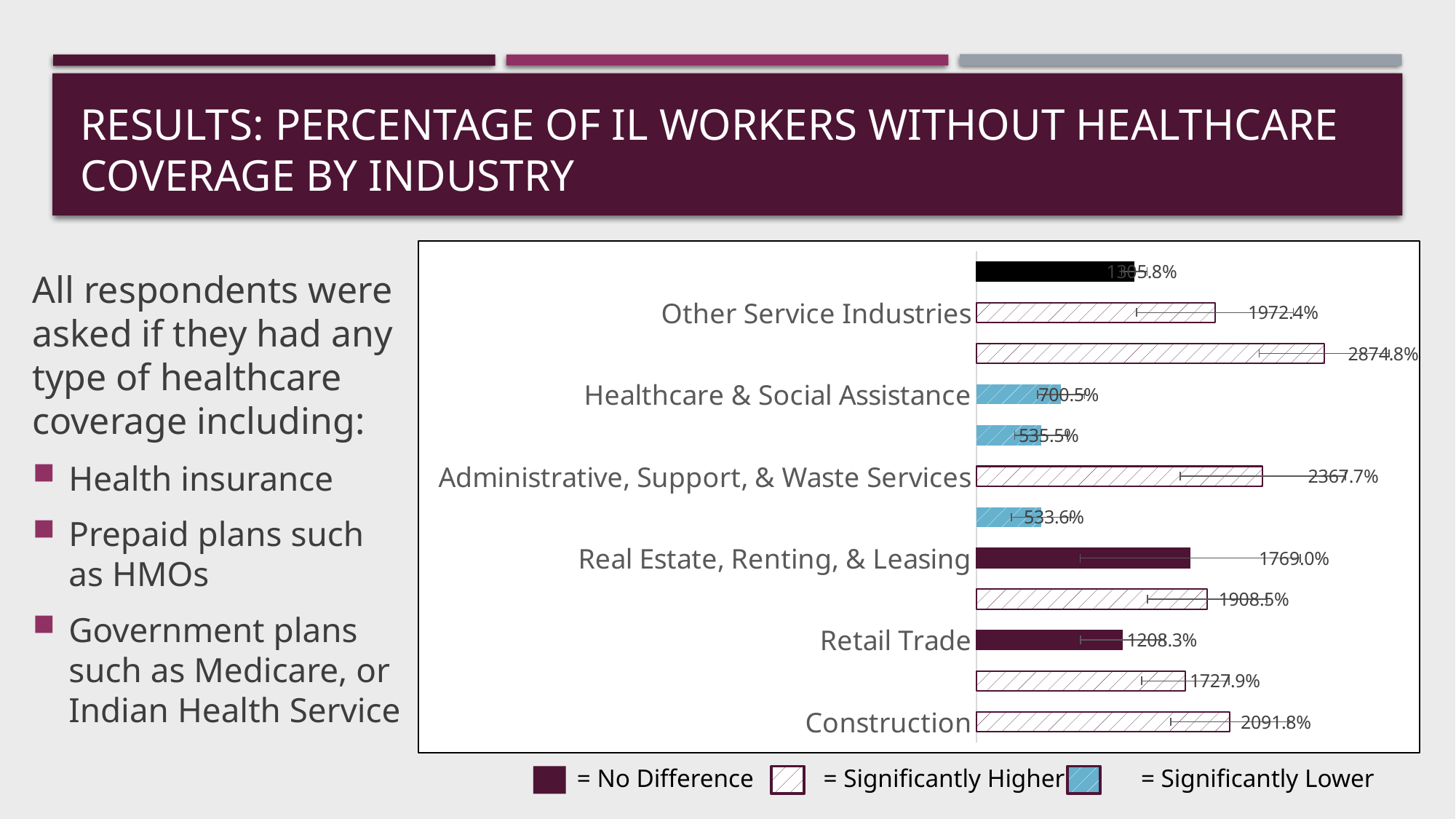
Of the labelled industries, which has the lowest value? Healthcare & Social Assistance Which is larger, the value for Other Service Industries or the value for Retail Trade? Other Service Industries According to the legend, what does a solid dark bar indicate? No Difference Which is larger, the value for Construction or the value for Retail Trade? Construction Which is larger, the value for Administrative, Support, & Waste Services or the value for Healthcare & Social Assistance? Administrative, Support, & Waste Services According to the legend, what does a blue hatched bar indicate? Significantly Lower How many industry categories are labelled on the chart's vertical axis? 6 What kind of chart is shown on the slide? bar chart How many entries does the chart legend list? 3